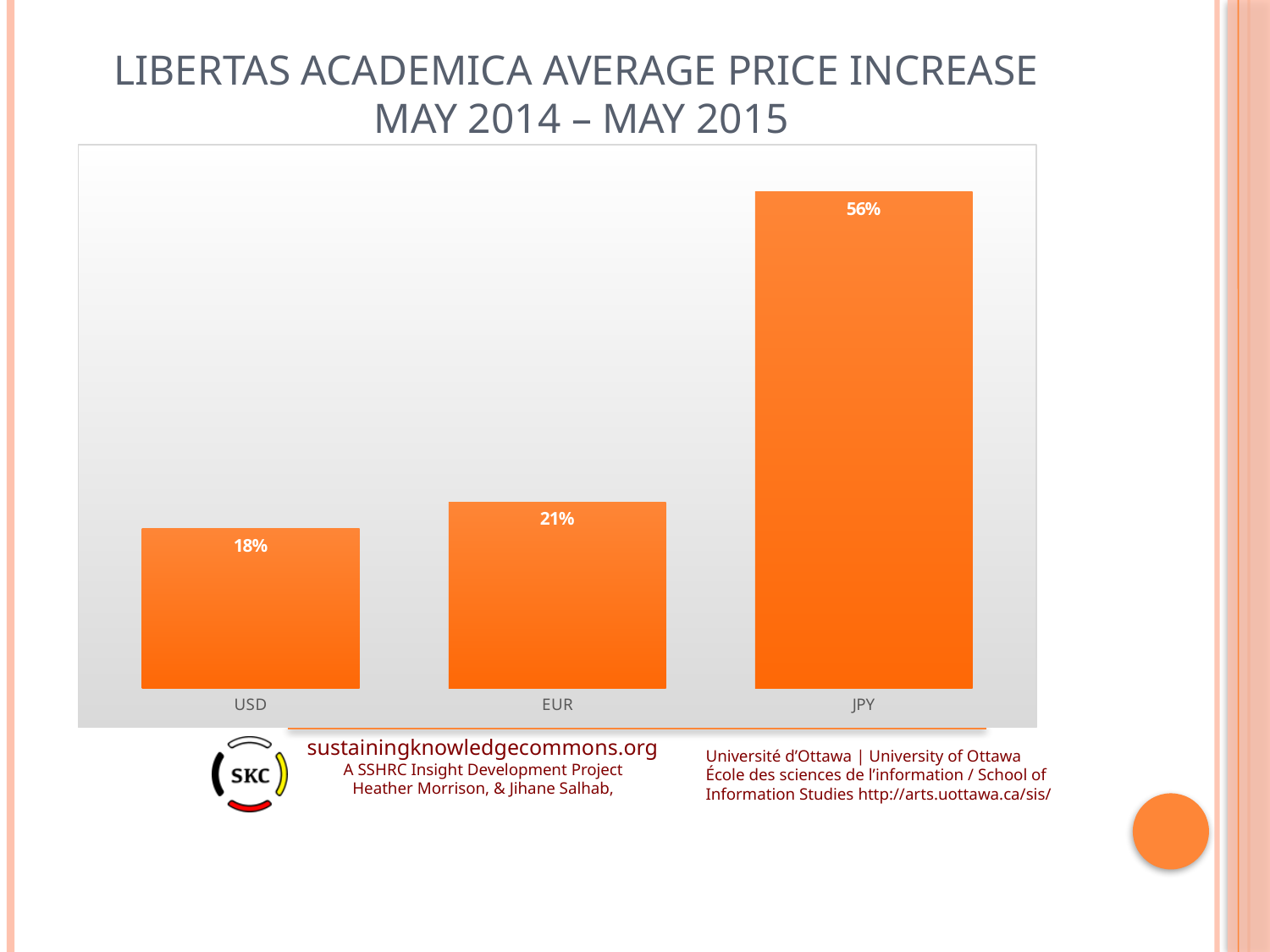
Which has a larger average price increase, EUR or JPY? JPY What is the title of the chart on the slide? Libertas Academica Average Price Increase May 2014 – May 2015 What is the average price increase for JPY? 56% What is the difference between the EUR and USD average price increases? 3% What kind of chart is shown on the slide? Bar chart Which currency shows the lowest average price increase? USD What is the average price increase for USD? 18% How many currencies are shown in the chart? 3 Do the values rise or fall from USD to JPY along the x axis? Rise Which currency shows the highest average price increase? JPY What is the difference between the JPY and USD average price increases? 38% What is the average price increase for EUR? 21%